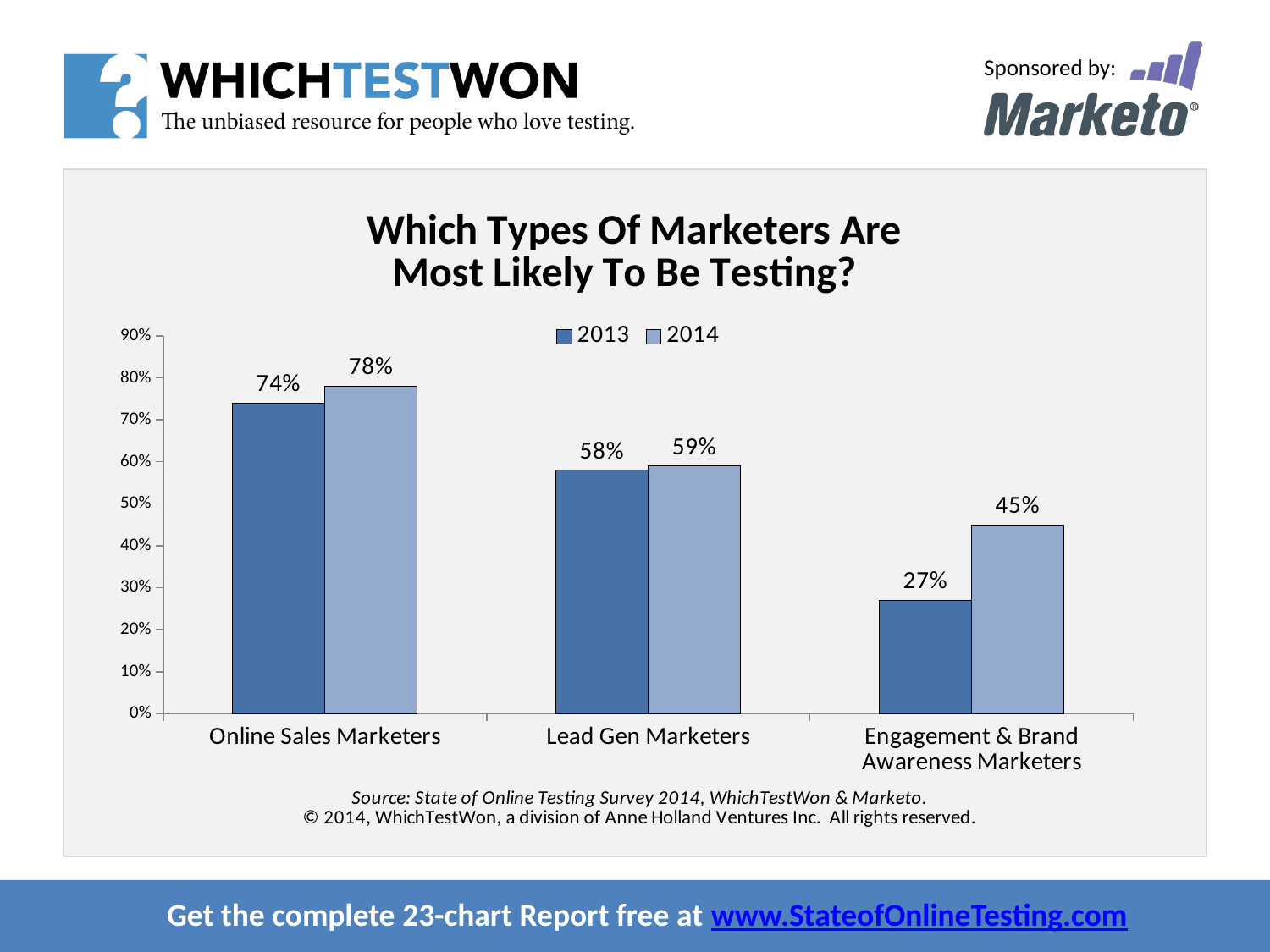
What is the 2013 value for Lead Gen Marketers? 58% Which is larger: the 2014 value for Lead Gen Marketers or the 2014 value for Engagement & Brand Awareness Marketers? Lead Gen Marketers How many categories are shown on the x axis? 3 What is the 2013 value for Engagement & Brand Awareness Marketers? 27% What is the title of the chart? Which Types Of Marketers Are Most Likely To Be Testing? What is the difference between the 2014 and 2013 values for Engagement & Brand Awareness Marketers? 18% What is the difference between the 2013 values for Online Sales Marketers and Lead Gen Marketers? 16% What is the 2014 value for Online Sales Marketers? 78% Which category has the highest 2014 value? Online Sales Marketers Which category has the lowest 2013 value? Engagement & Brand Awareness Marketers What kind of chart is shown on the slide? Bar chart How many series does the legend list? 2